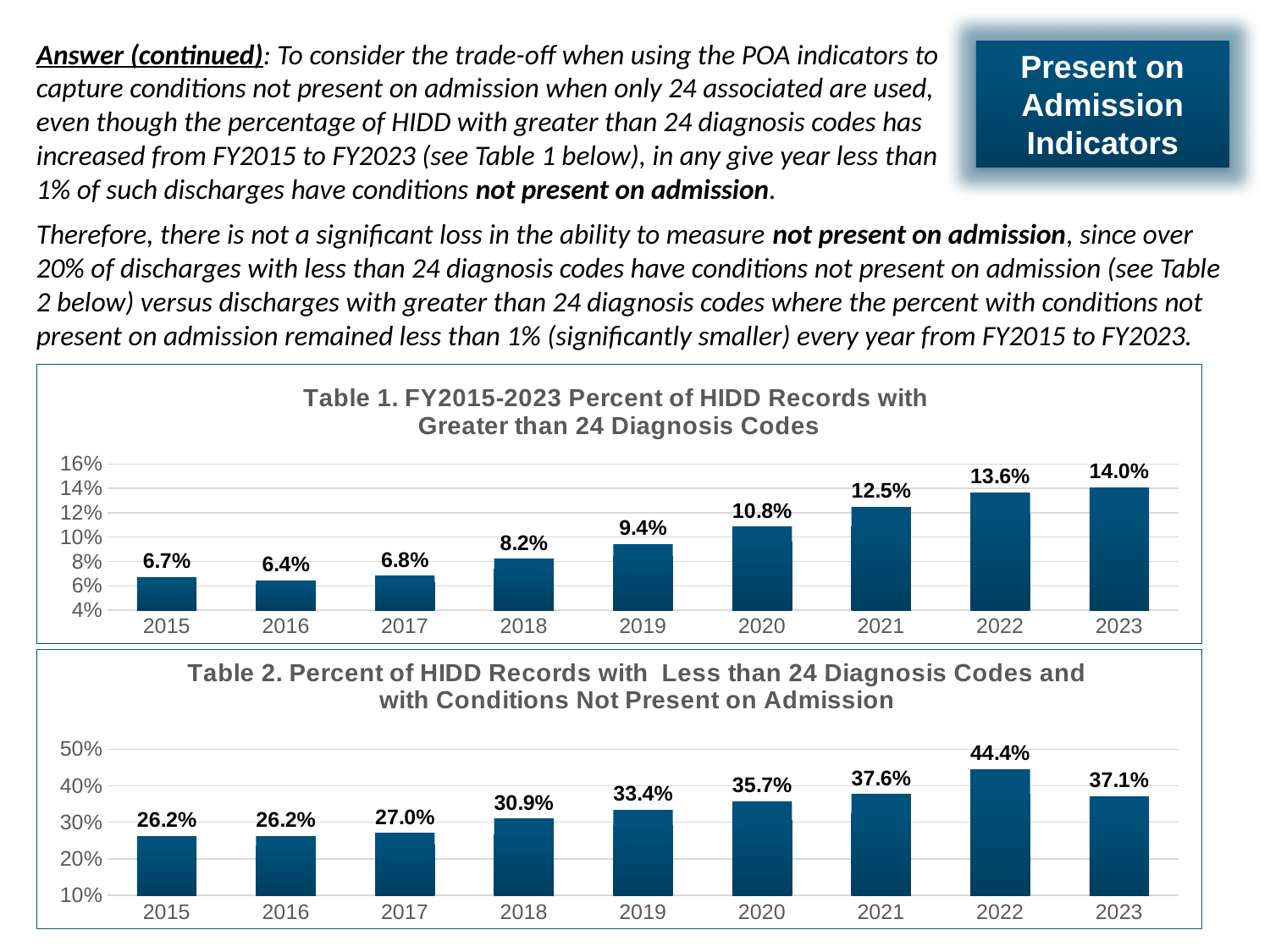
In the Table 1 chart, what is the difference between the values for 2023 and 2015? 7.3% In the Table 2 chart, which year has the highest value? 2022 What kind of chart is the Table 1 chart? bar chart In the Table 1 chart, do the values generally rise or fall from 2017 to 2023? rise How many years are shown on the x axis of the Table 2 chart? 9 In the Table 2 chart, what is the difference between the values for 2022 and 2023? 7.3% In the Table 2 chart, which is larger, the value for 2020 or the value for 2019? 2020 What is the title of the top chart on the slide? Table 1. FY2015-2023 Percent of HIDD Records with Greater than 24 Diagnosis Codes In the Table 1 chart, is the value for 2021 greater or less than 10%? greater In the Table 2 chart, what is the value for 2021? 37.6% In the Table 1 chart, what is the value for 2019? 9.4% In the Table 1 chart, which year has the lowest value? 2016